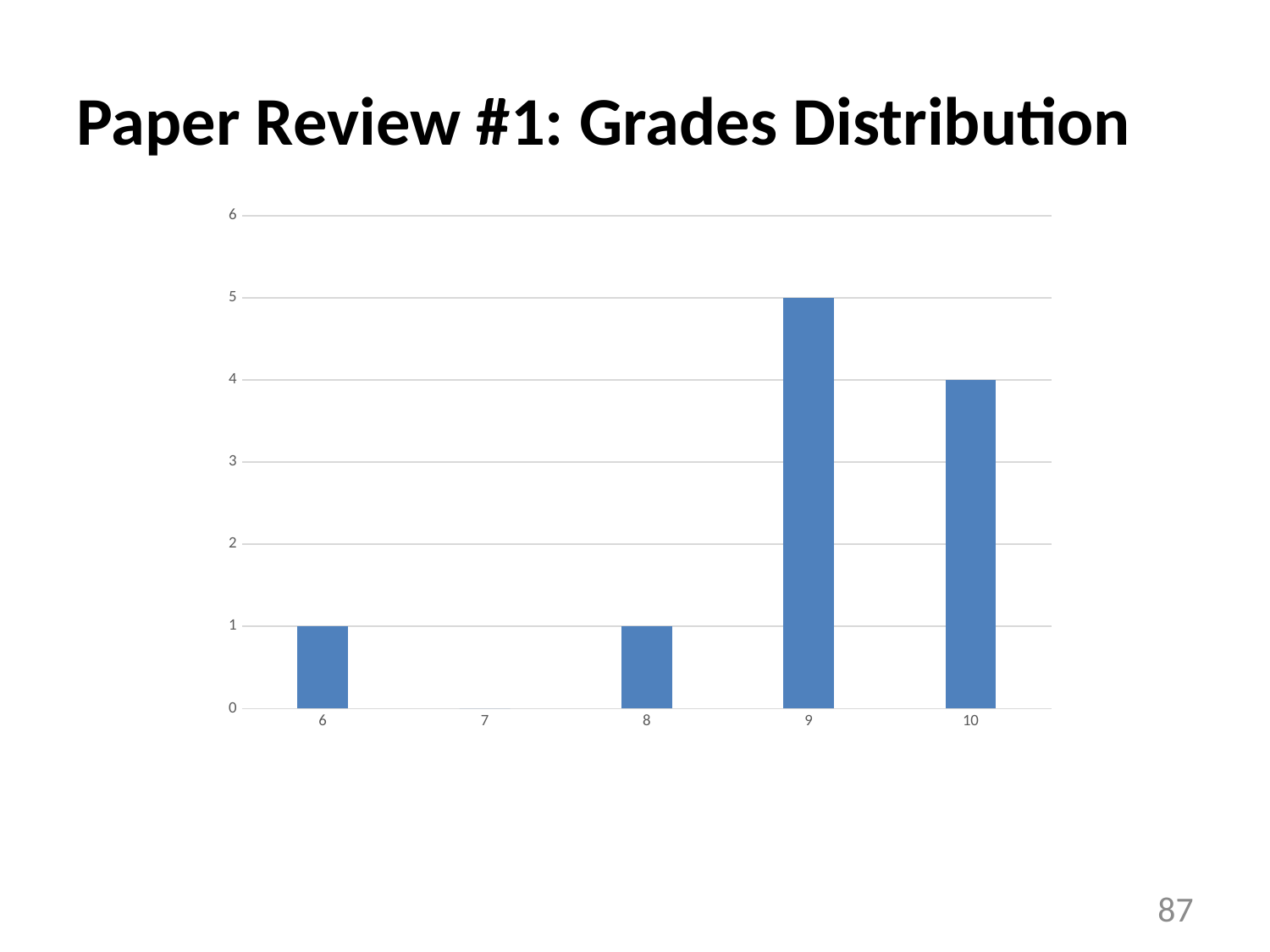
Which grade has no bar at all? 7 Which grade has the highest bar? 9 What is the value for grade 6? 1 What is the title of the slide containing the chart? Paper Review #1: Grades Distribution What kind of chart is shown on the slide? bar chart What is the value for grade 9? 5 How many grade categories are shown on the x axis? 5 Is the value for grade 10 greater or less than 3? greater Which is larger, the value for grade 9 or the value for grade 10? grade 9 What is the difference between the values for grade 9 and grade 10? 1 What is the value for grade 10? 4 What is the value for grade 8? 1